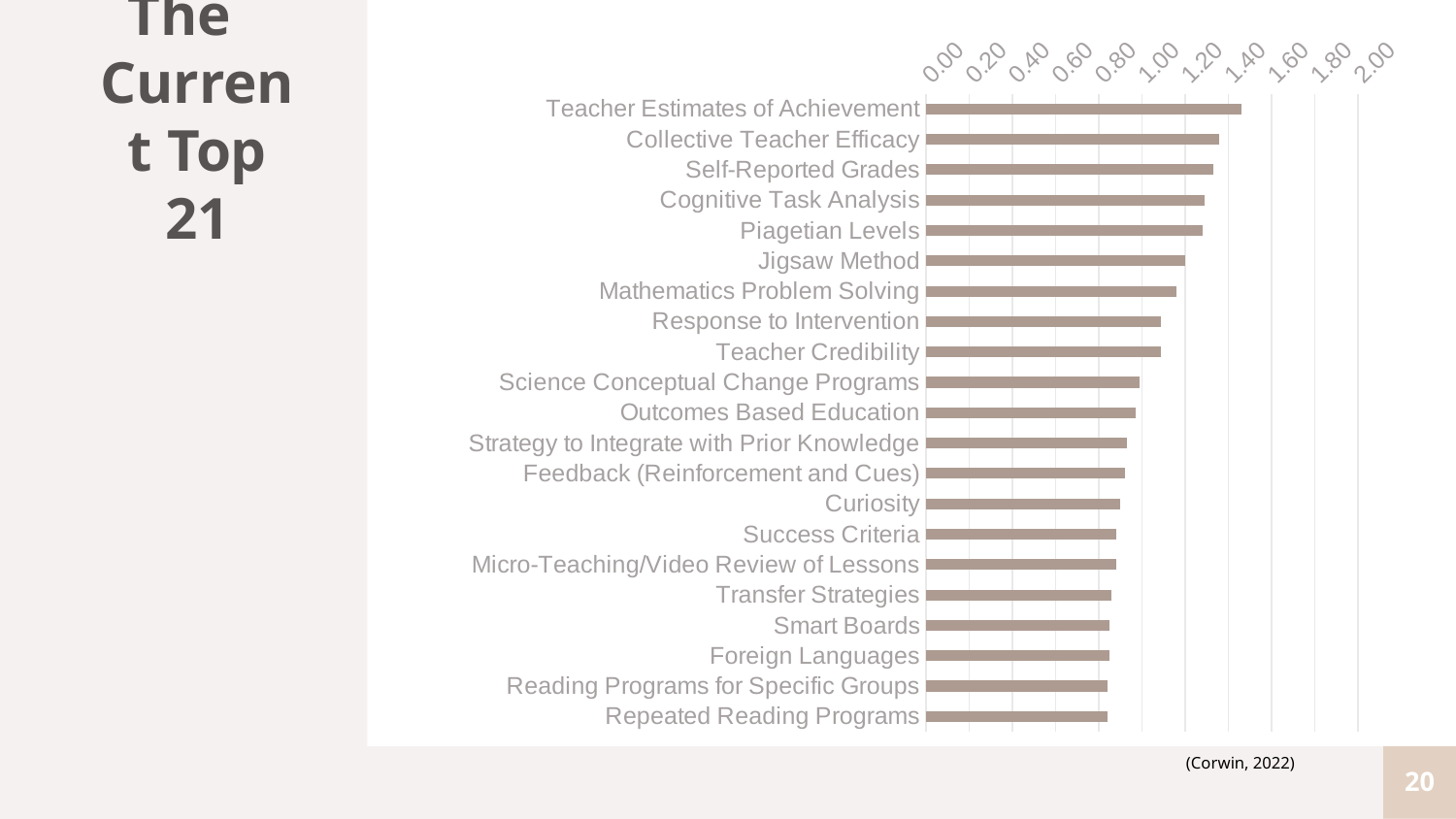
What kind of chart is shown on the slide? bar chart Is the value for Smart Boards greater or less than 1.20? less Which category has the highest value in the chart? Teacher Estimates of Achievement Is the value for Jigsaw Method greater or less than 1.00? greater How many categories are plotted in the chart? 21 Which has the larger value, Teacher Estimates of Achievement or Curiosity? Teacher Estimates of Achievement Is the value for Repeated Reading Programs greater or less than 1.00? less Do the bar values increase or decrease going from the top category to the bottom category? decrease What source is cited below the chart? (Corwin, 2022) Which has the larger value, Jigsaw Method or Smart Boards? Jigsaw Method